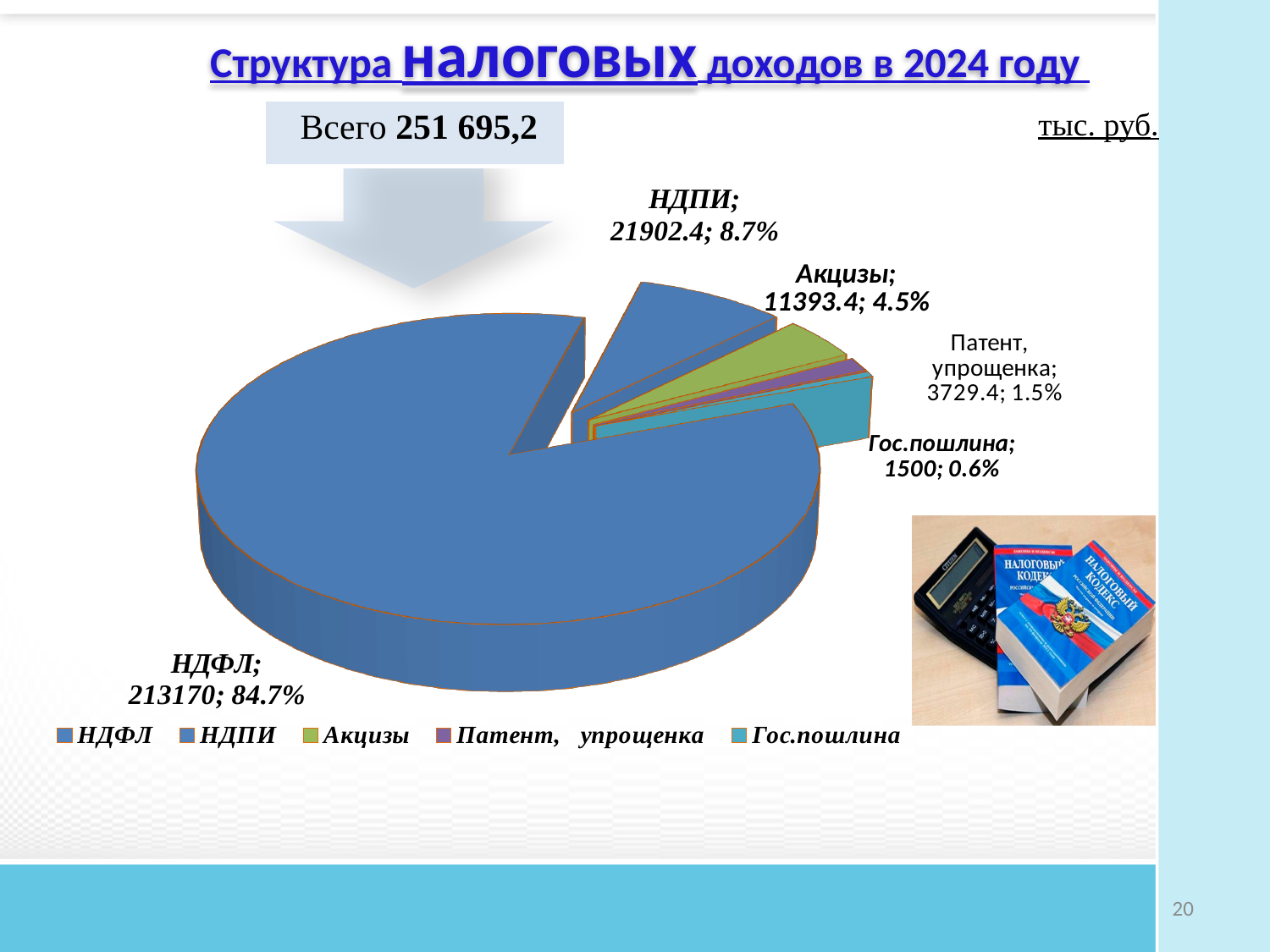
What total is shown above the chart? 251 695,2 Which category has the largest share of the pie? НДФЛ What kind of chart is shown on the slide? pie chart What share of the pie does НДПИ represent? 8.7% Which category has the smallest share of the pie? Гос.пошлина What is the value for Акцизы? 11393.4 What is the value for Гос.пошлина? 1500 What is the difference between the values for НДПИ and Акцизы? 10509 Which is larger, the value for НДПИ or the value for Акцизы? НДПИ What is the value for НДФЛ? 213170 How many categories does the pie chart have? 5 What share of the pie does Патент, упрощенка represent? 1.5%